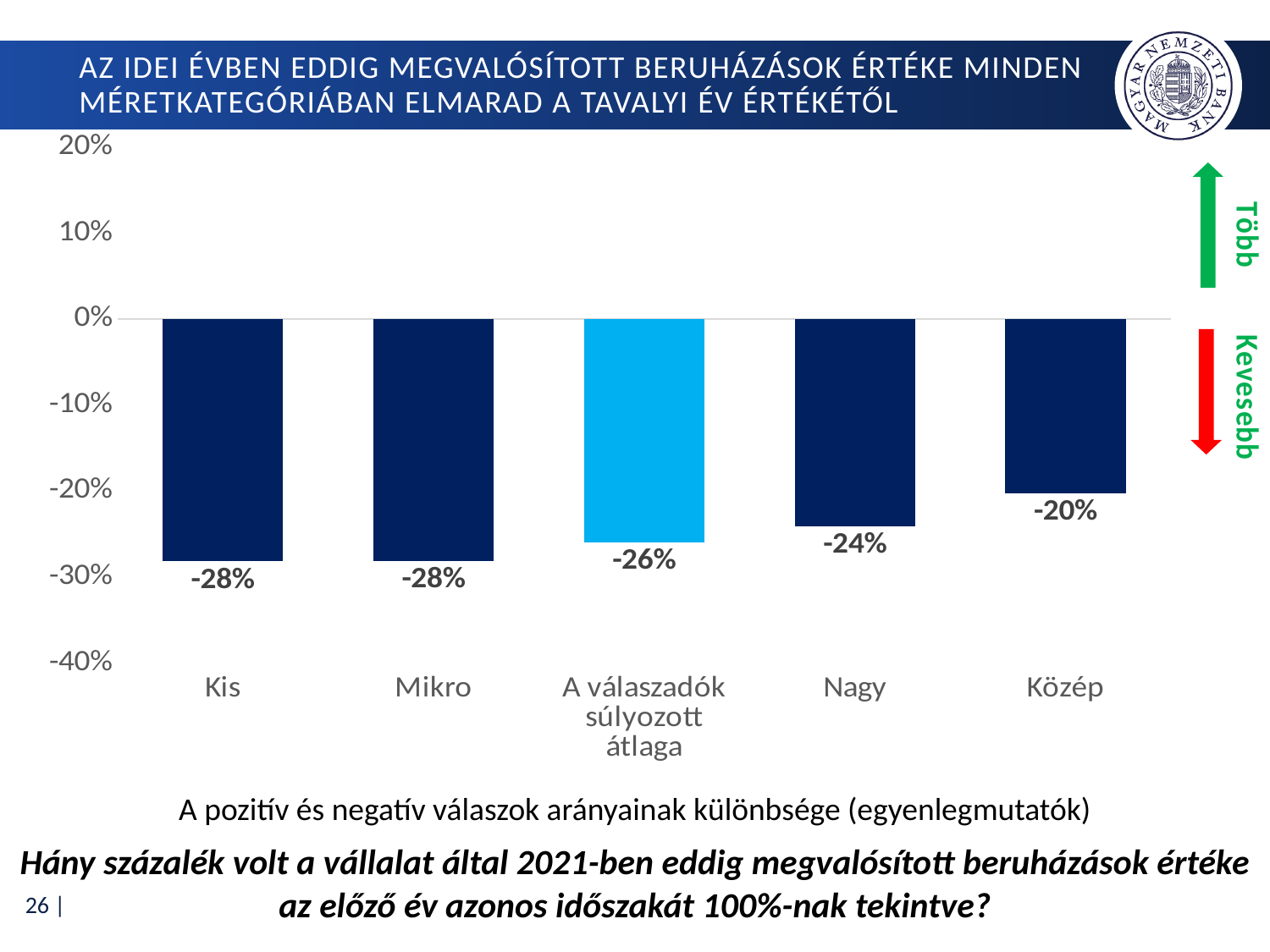
What is the difference between the values for Közép and Kis? 8 percentage points What is the value for Nagy? -24% Which is larger, the value for Nagy or the value for Mikro? Nagy What kind of chart is shown on the slide? Bar chart What is the difference between the values for Nagy and A válaszadók súlyozott átlaga? 2 percentage points What is the value for Kis? -28% Which category has the lowest value? Kis and Mikro Which category has the highest value? Közép Which bar is shown in a lighter blue colour than the others? A válaszadók súlyozott átlaga What is the value for A válaszadók súlyozott átlaga? -26% How many categories are shown on the x axis? 5 What is the value for Közép? -20%